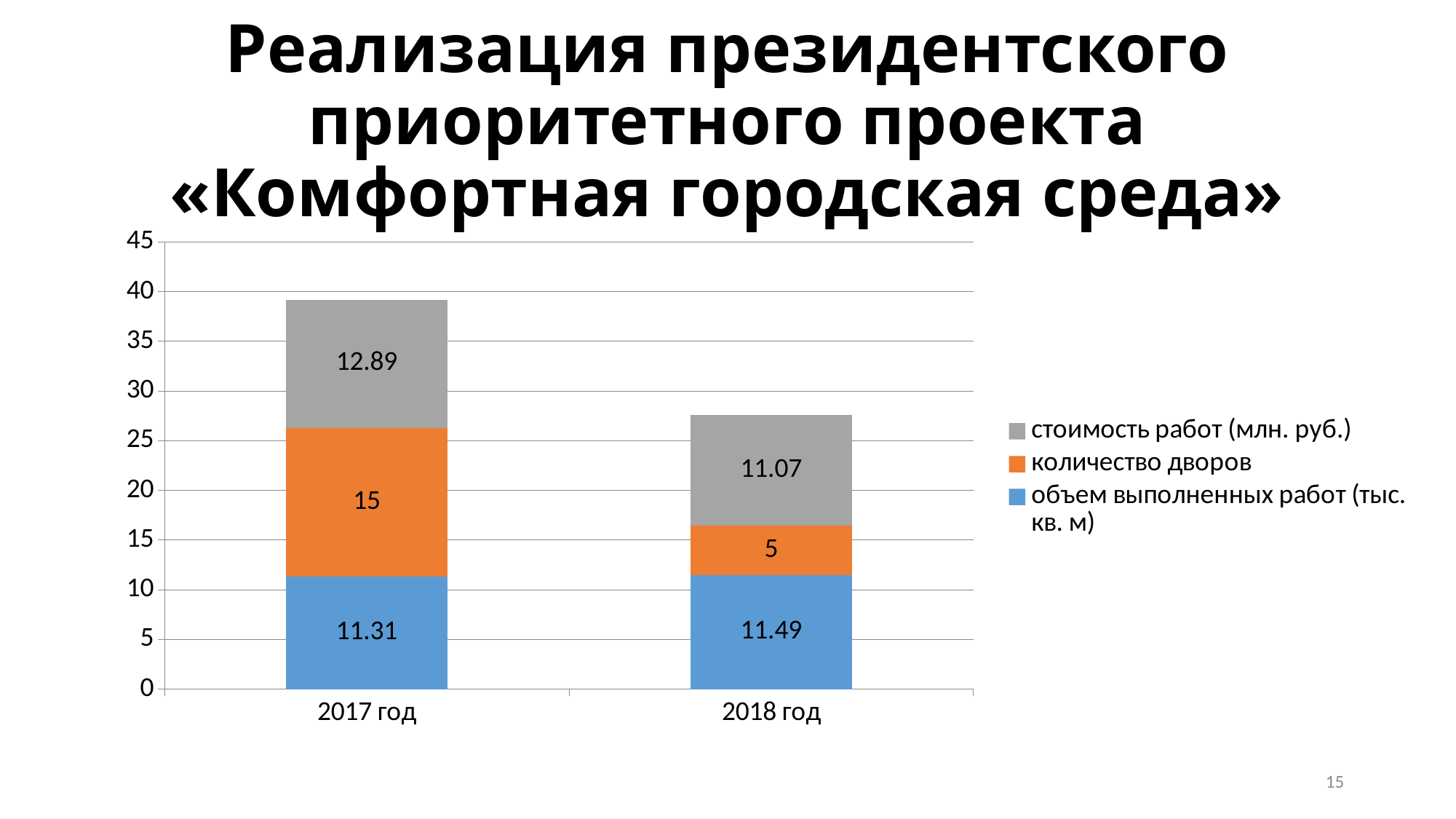
What is the value of количество дворов for 2018 год? 5 How many categories are shown on the x axis? 2 What is the value of стоимость работ (млн. руб.) for 2018 год? 11.07 What is the total of the stacked bar for 2017 год? 39.2 What is the value of объем выполненных работ (тыс. кв. м) for 2017 год? 11.31 Which year has the higher value for количество дворов? 2017 год What is the total of the stacked bar for 2018 год? 27.56 What is the difference between the стоимость работ (млн. руб.) values for 2017 год and 2018 год? 1.82 What is the difference between the количество дворов values for 2017 год and 2018 год? 10 How many series does the legend list? 3 What kind of chart is shown on the slide? Stacked bar chart What is the value of стоимость работ (млн. руб.) for 2017 год? 12.89